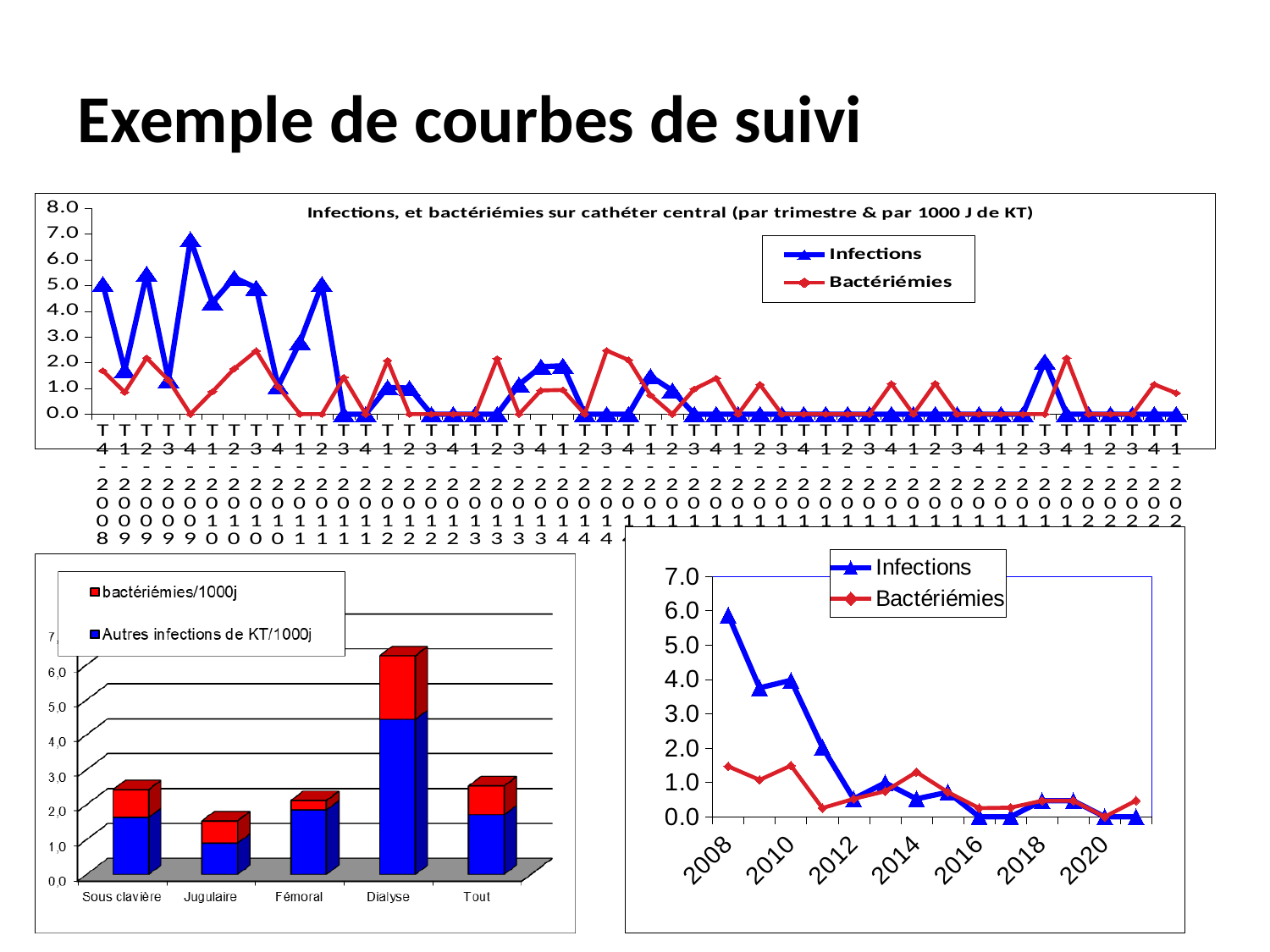
In the top chart, do the Infections values generally rise or fall from left to right along the x axis? fall In the bottom-left bar chart, which category has the tallest stacked bar? Dialyse In the bottom-right line chart, which series has the larger value in 2008, Infections or Bactériémies? Infections What kind of chart is the bottom-left chart with categories Sous clavière, Jugulaire, Fémoral, Dialyse and Tout? bar chart How many categories are shown on the x axis of the bottom-left bar chart? 5 In the bottom-left bar chart, which category has the shortest stacked bar? Jugulaire In the bottom-left bar chart, is the total stacked value for Dialyse greater or less than 6.0? greater How many series does the legend of the top chart list? 2 What are the two series named in the legend of the top chart? Infections and Bactériémies In the bottom-right line chart, is the Infections value for 2008 greater or less than 5.0? greater What kind of chart is the top chart titled 'Infections, et bactériémies sur cathéter central'? line chart In the top chart, is the Infections value for the first quarter shown (T4-2008) greater or less than 4.0? greater